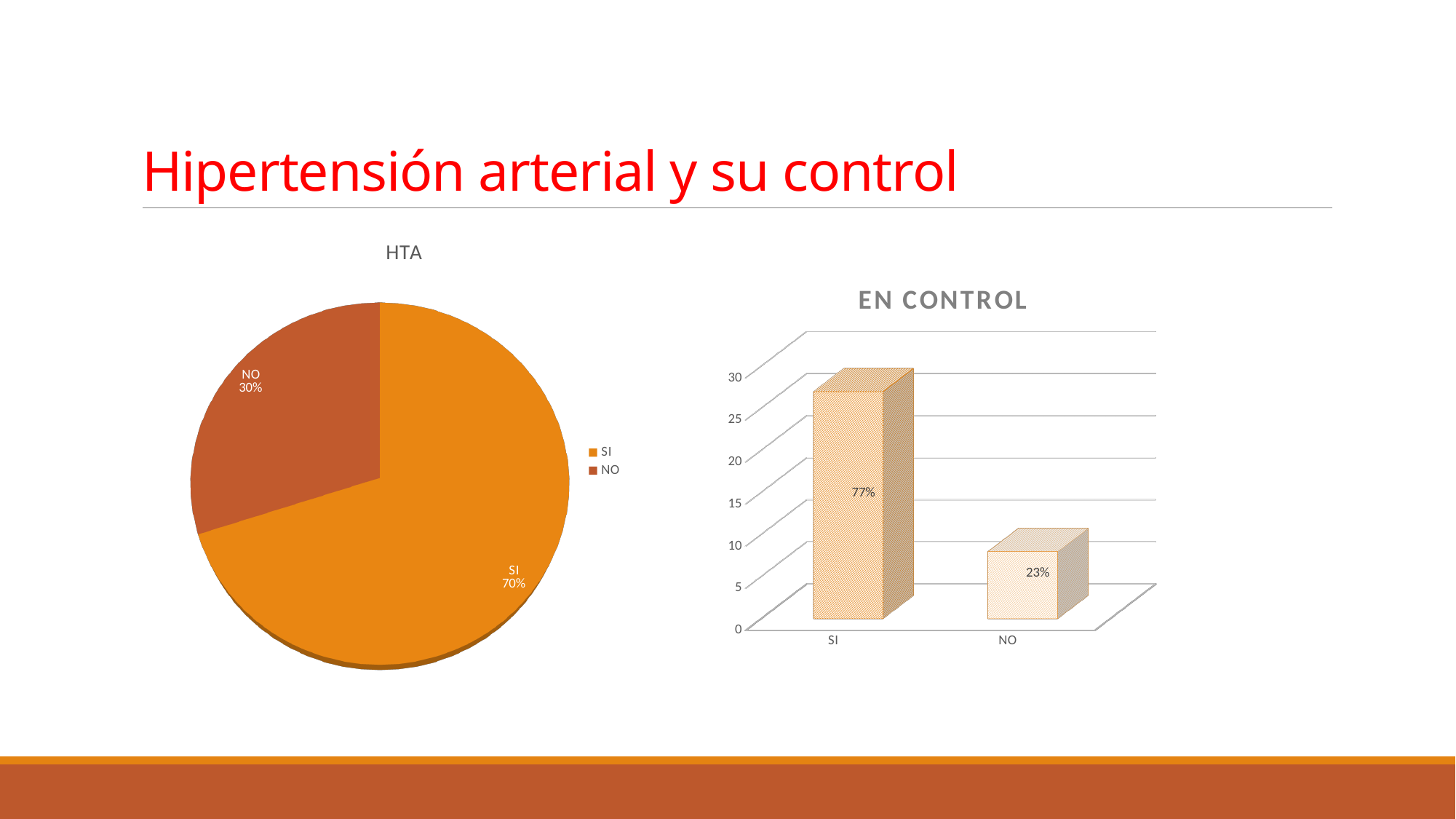
What kind of chart is the EN CONTROL chart on the right? Bar chart In the EN CONTROL chart, is the bar for SI greater or less than 20 on the axis? greater In the EN CONTROL chart, what data label is shown on the NO bar? 23% In the HTA pie chart, how many entries does the legend list? 2 In the EN CONTROL chart, what data label is shown on the SI bar? 77% In the HTA pie chart, how many slices are there? 2 What kind of chart is the HTA chart on the left? Pie chart In the HTA pie chart, what share does the NO slice represent? 30% In the EN CONTROL chart, which category has the shortest bar? NO In the EN CONTROL chart, which category has the tallest bar? SI In the HTA pie chart, which slice is larger, SI or NO? SI In the HTA pie chart, what share does the SI slice represent? 70%